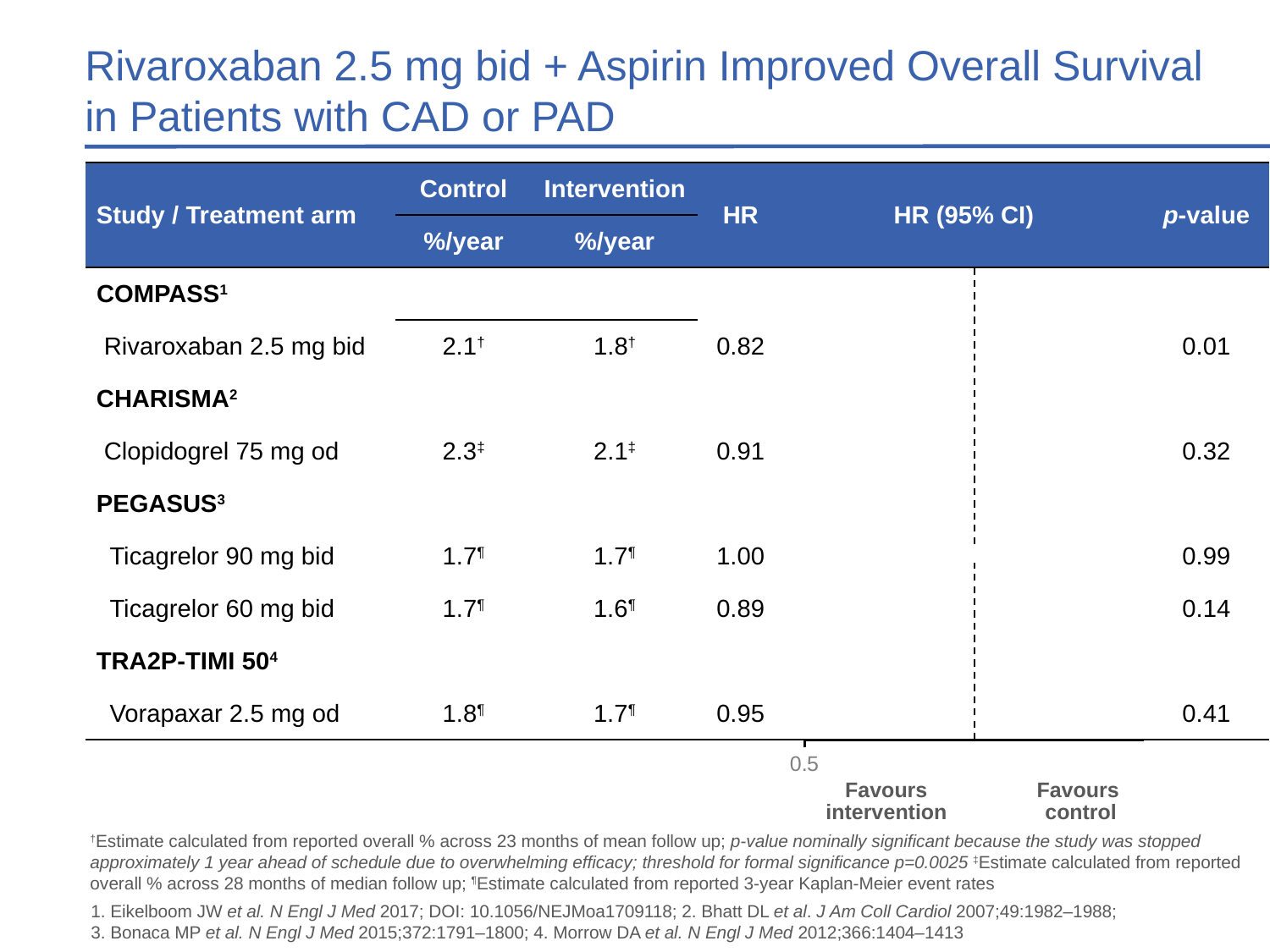
Which treatment arm has the lowest HR? Rivaroxaban 2.5 mg bid What is the difference between the control and intervention %/year rates for Rivaroxaban 2.5 mg bid in COMPASS? 0.3 What is the hazard ratio (HR) for Rivaroxaban 2.5 mg bid in the COMPASS study? 0.82 What tick value is printed on the HR axis at the bottom of the plot? 0.5 Which treatment arm has the highest HR? Ticagrelor 90 mg bid What label appears on the left side of the HR axis below the plot? Favours intervention What is the p-value for Clopidogrel 75 mg od in the CHARISMA study? 0.32 What is the HR for Ticagrelor 90 mg bid in the PEGASUS study? 1.00 How many treatment arms are listed in the table? 5 Which treatment arm has the smallest p-value? Rivaroxaban 2.5 mg bid Which has the larger HR, Clopidogrel 75 mg od or Vorapaxar 2.5 mg od? Vorapaxar 2.5 mg od What is the control event rate (%/year) for Vorapaxar 2.5 mg od in TRA2P-TIMI 50? 1.8